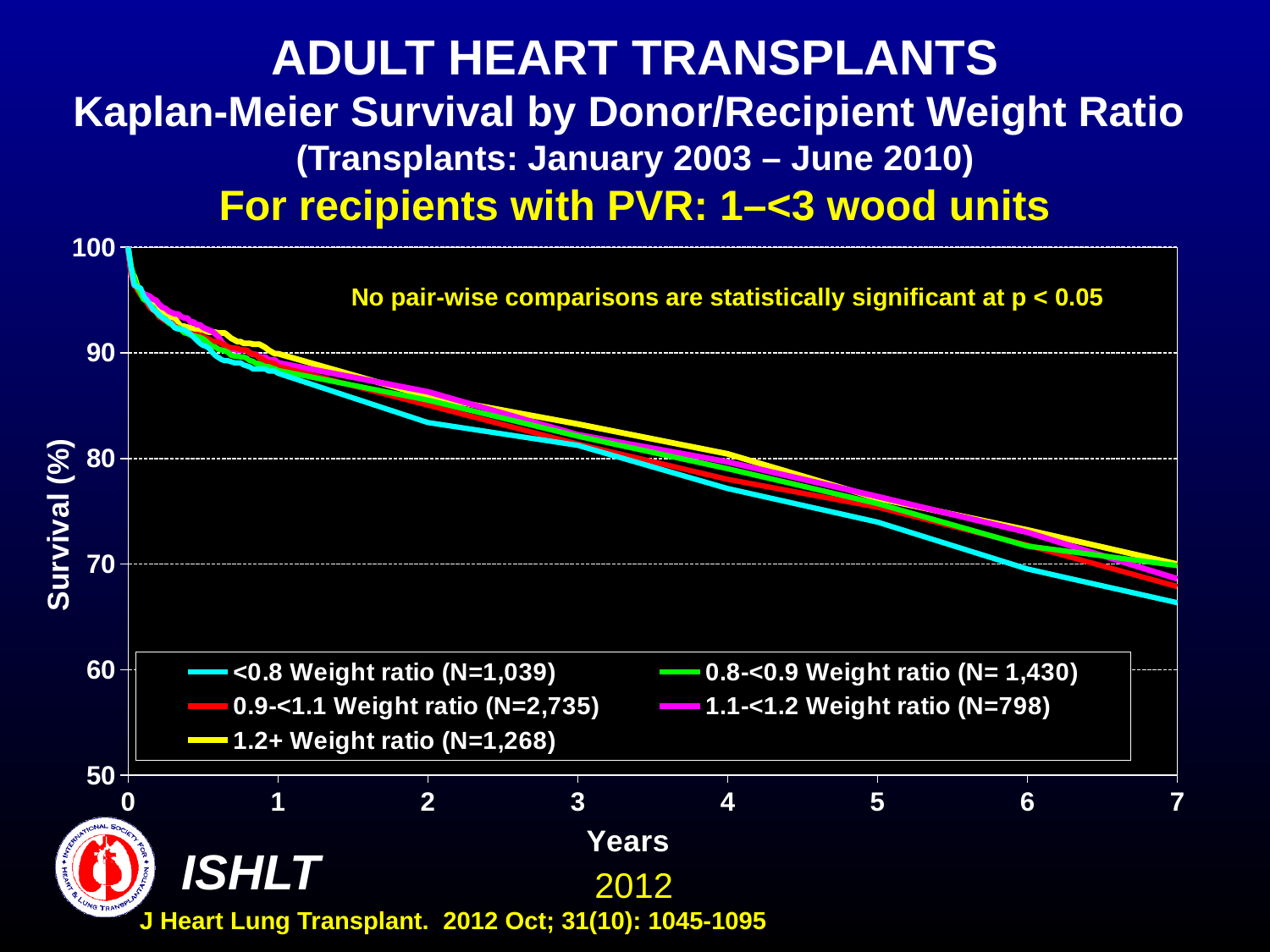
Which weight ratio group has the lowest survival at 7 years? <0.8 Weight ratio What colour is the line for the 1.2+ weight ratio group? yellow At 7 years, which has higher survival: the 1.2+ weight ratio group or the <0.8 weight ratio group? 1.2+ Weight ratio At 4 years, is survival for the <0.8 weight ratio group greater or less than 80%? less How many weight ratio groups does the legend list? 5 Do the survival curves rise or fall as years increase? fall What kind of chart is shown on the slide? line chart At 7 years, is survival for the <0.8 weight ratio group greater or less than 70%? less At 2 years, is survival for the 1.2+ weight ratio group greater or less than 80%? greater What is the N for the 0.9-<1.1 weight ratio group shown in the legend? N=2,735